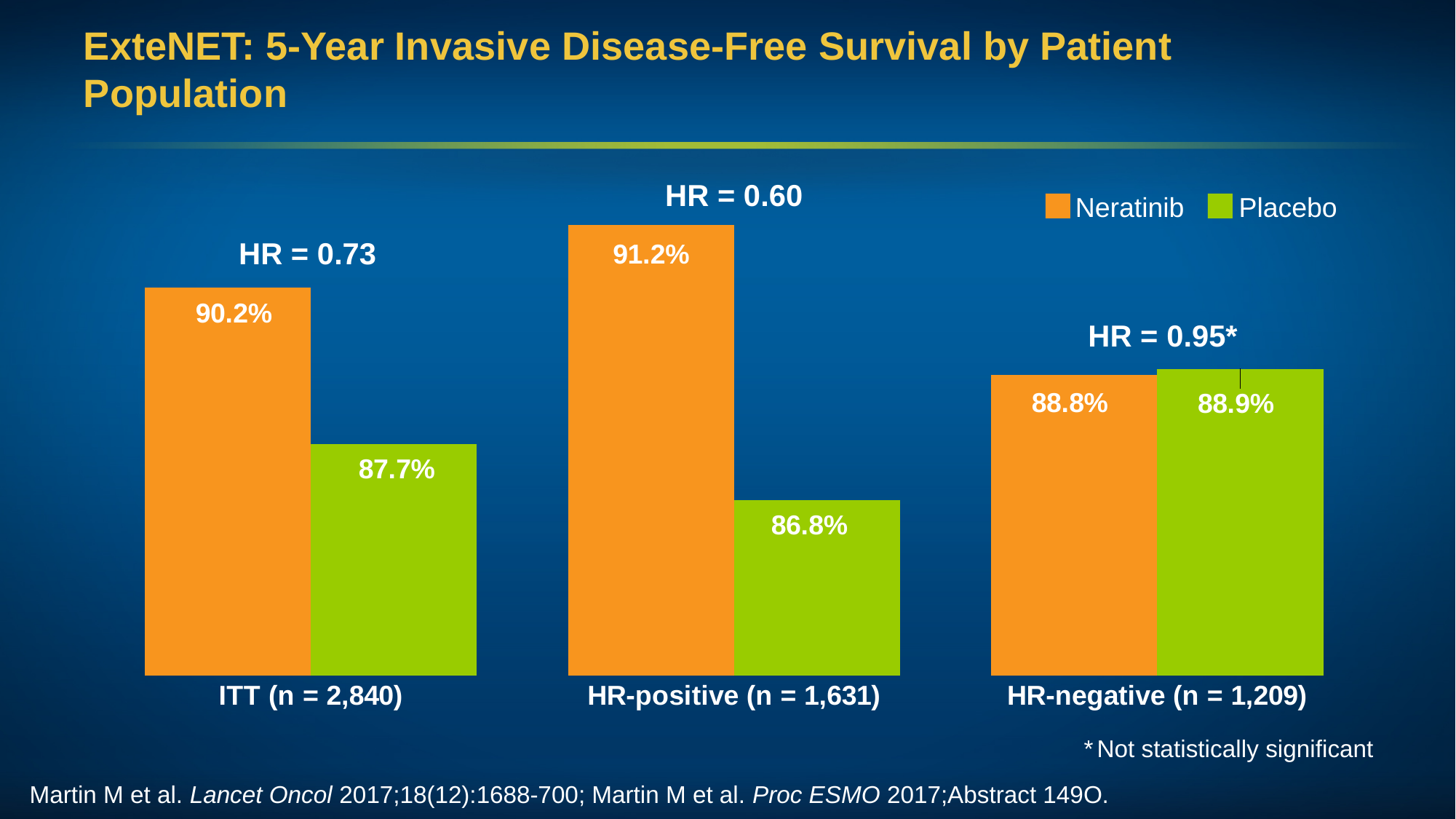
What is the 5-year invasive disease-free survival for Neratinib in the ITT population? 90.2% What is the 5-year invasive disease-free survival for Placebo in the HR-positive population? 86.8% In which patient population is the Placebo value lowest? HR-positive (n = 1,631) What kind of chart is shown on the slide? Bar chart What is the difference between the Neratinib and Placebo values in the HR-positive population? 4.4% What is the difference between the Neratinib and Placebo values in the ITT population? 2.5% In the ITT population, which is larger, the Neratinib value or the Placebo value? Neratinib How many patient populations are shown on the x axis? 3 What is the value for Placebo in the ITT population? 87.7% What is the value for Neratinib in the HR-negative population? 88.8% In which patient population is the Neratinib value highest? HR-positive (n = 1,631) How many series does the legend list? 2